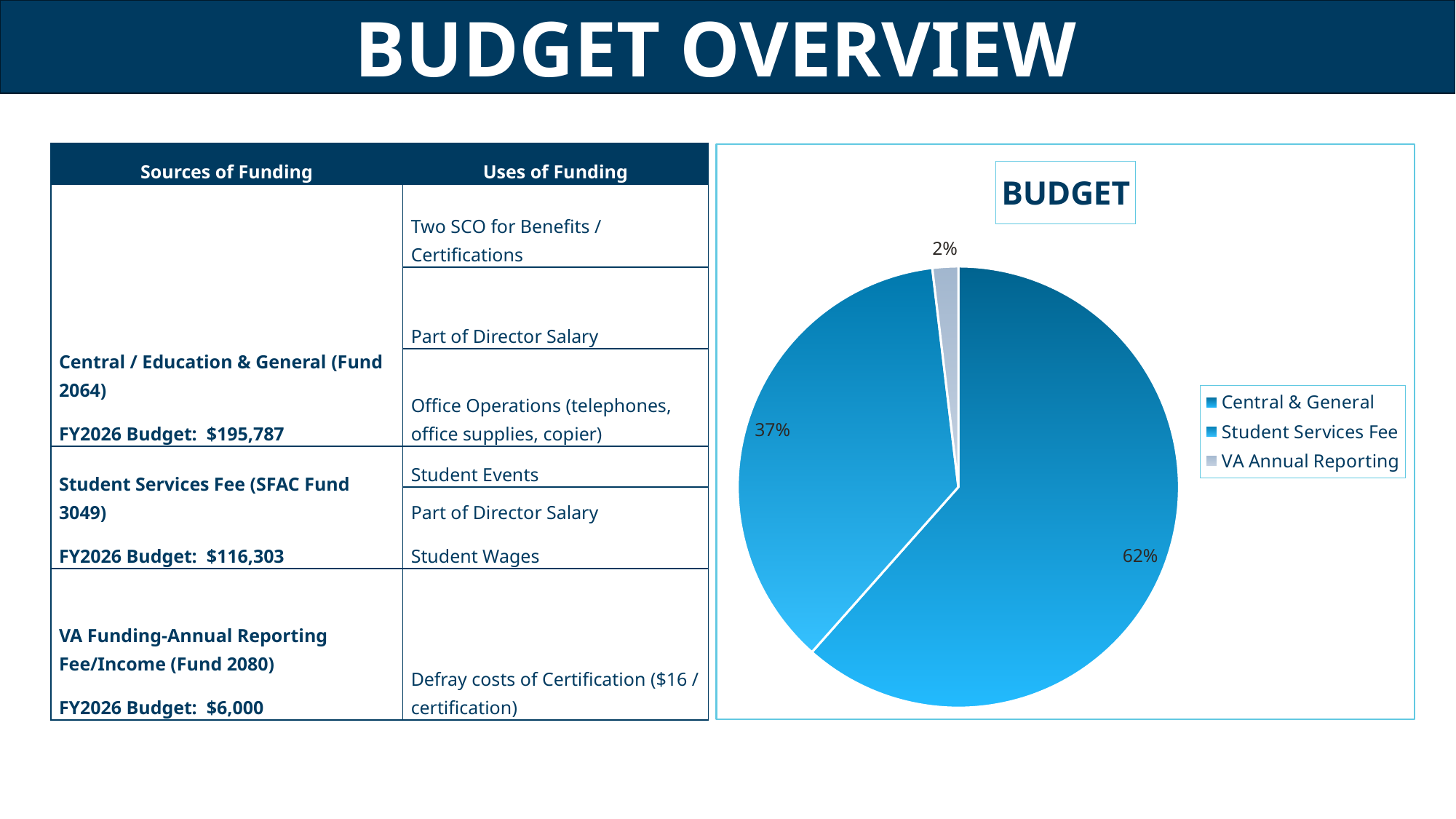
Which legend entry is shown in the lightest colour? VA Annual Reporting What is the title of the chart? BUDGET How many slices does the pie chart have? 3 What share of the pie does VA Annual Reporting represent? 2% How many entries does the legend list? 3 What share of the pie does Central & General represent? 62% Which category has the largest slice of the pie? Central & General What share of the pie does Student Services Fee represent? 37% What kind of chart is shown on the slide? pie chart Which category has the smallest slice of the pie? VA Annual Reporting Which is larger, the Student Services Fee slice or the VA Annual Reporting slice? Student Services Fee What is the difference in percentage points between the Central & General slice and the Student Services Fee slice? 25